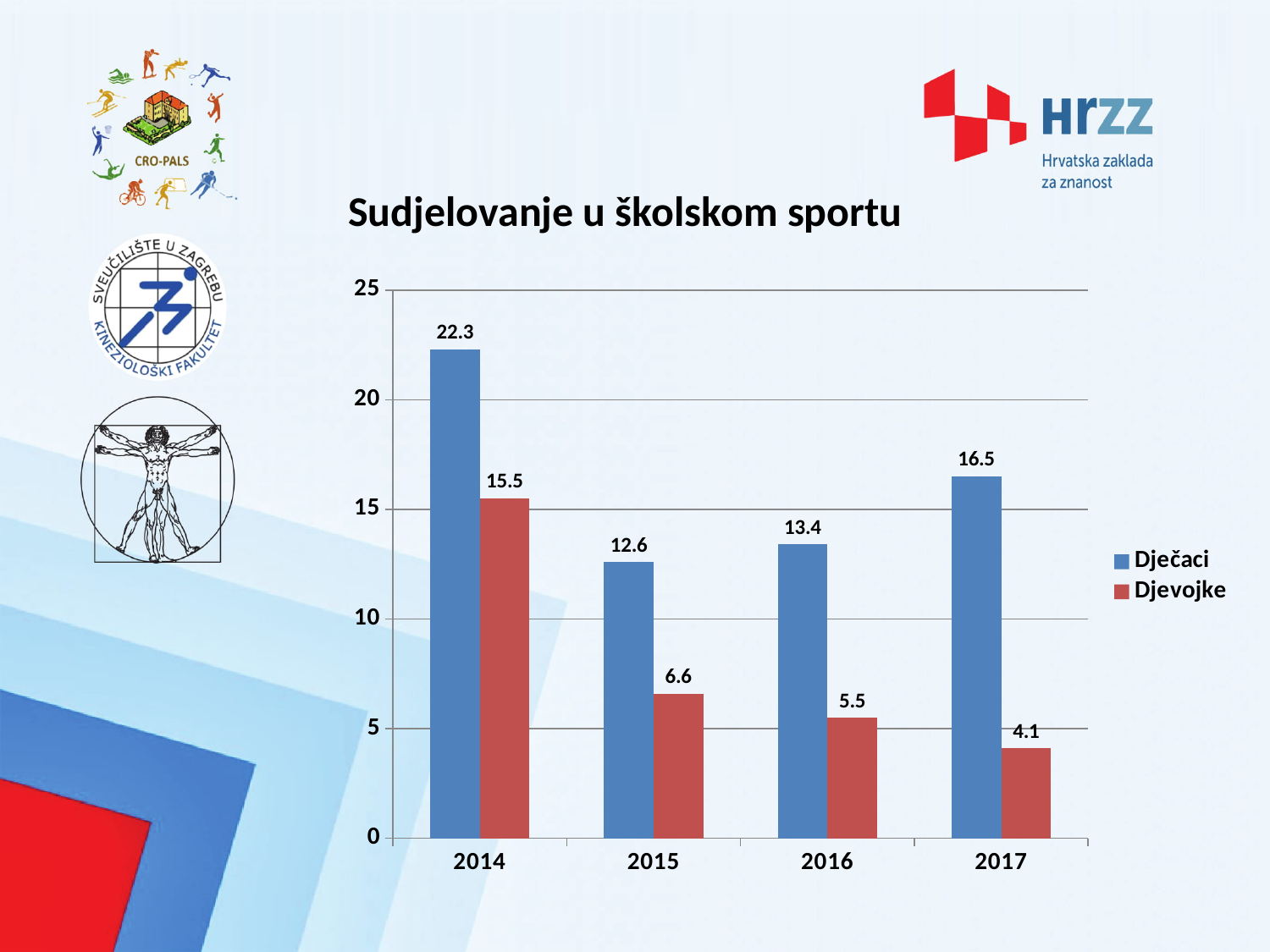
Which is larger, the Dječaci value in 2017 or the Dječaci value in 2016? 2017 What kind of chart is shown? bar chart What is the difference between the Dječaci and Djevojke values in 2016? 7.9 In which year is the Dječaci value lowest? 2015 How many years are shown on the x axis? 4 How many series does the legend list? 2 Is the value for Djevojke in 2014 greater or less than 15? greater Does the Djevojke value rise or fall from 2014 to 2017? fall What is the value for Djevojke in 2015? 6.6 What is the value for Djevojke in 2017? 4.1 What is the value for Dječaci in 2014? 22.3 In which year is the Djevojke value highest? 2014